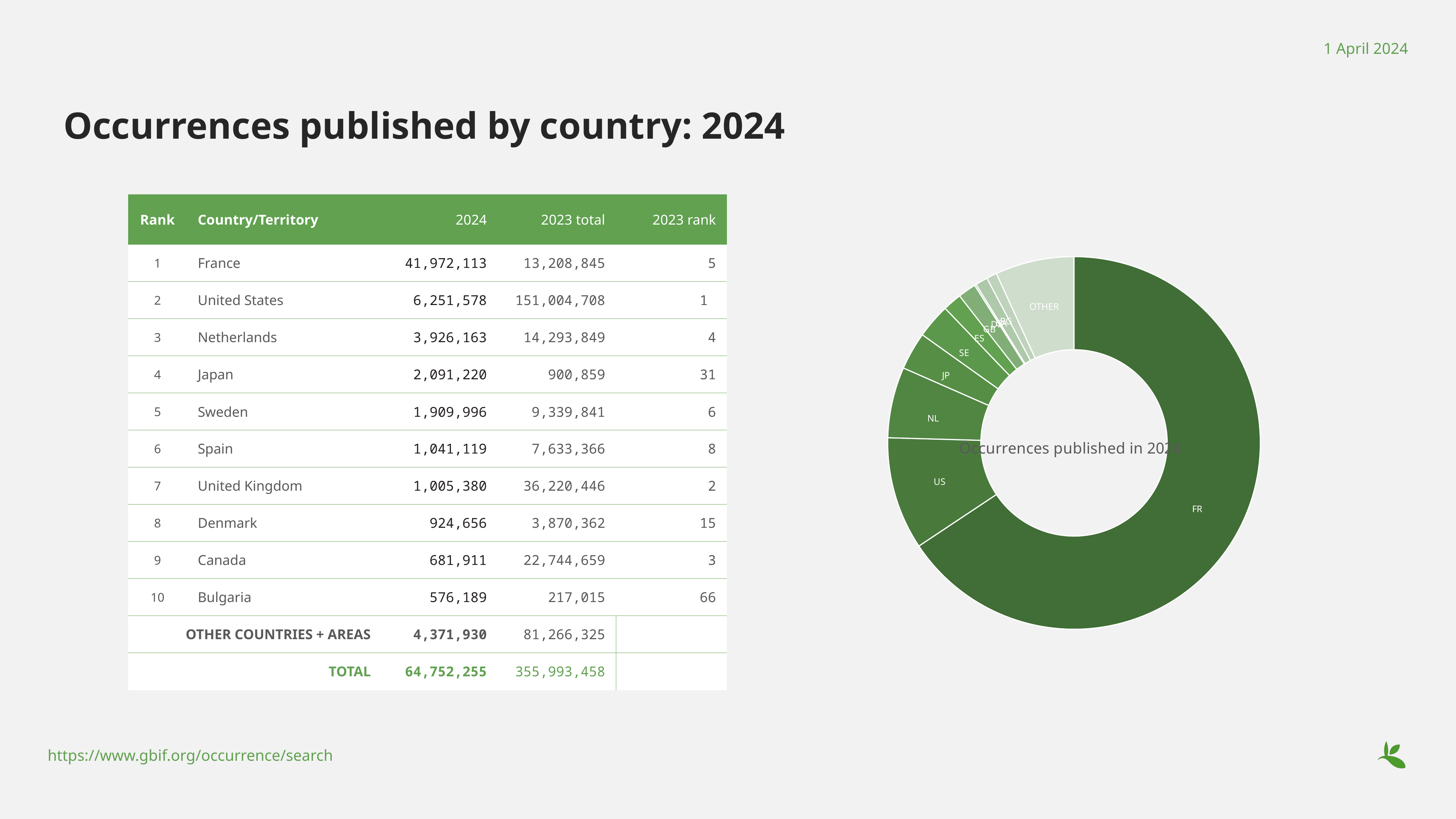
How many slices does the donut chart have, including OTHER? 11 What is the total of all 2024 occurrences shown on the slide? 64,752,255 What is the title shown in the centre of the donut chart? Occurrences published in 2024 What is the 2024 value for the United States (US) shown on the slide? 6,251,578 What kind of chart is shown on the right of the slide? doughnut chart What is the 2024 value for the OTHER COUNTRIES + AREAS slice shown on the slide? 4,371,930 Which slice is larger in the donut chart, US or NL? US What is the 2024 value for the Netherlands (NL) shown on the slide? 3,926,163 Which country has the largest slice in the donut chart? FR What is the difference between the 2024 values for France and the United States? 35,720,535 Which slice is larger in the donut chart, JP or SE? JP What is the 2024 value for France (FR) shown on the slide? 41,972,113